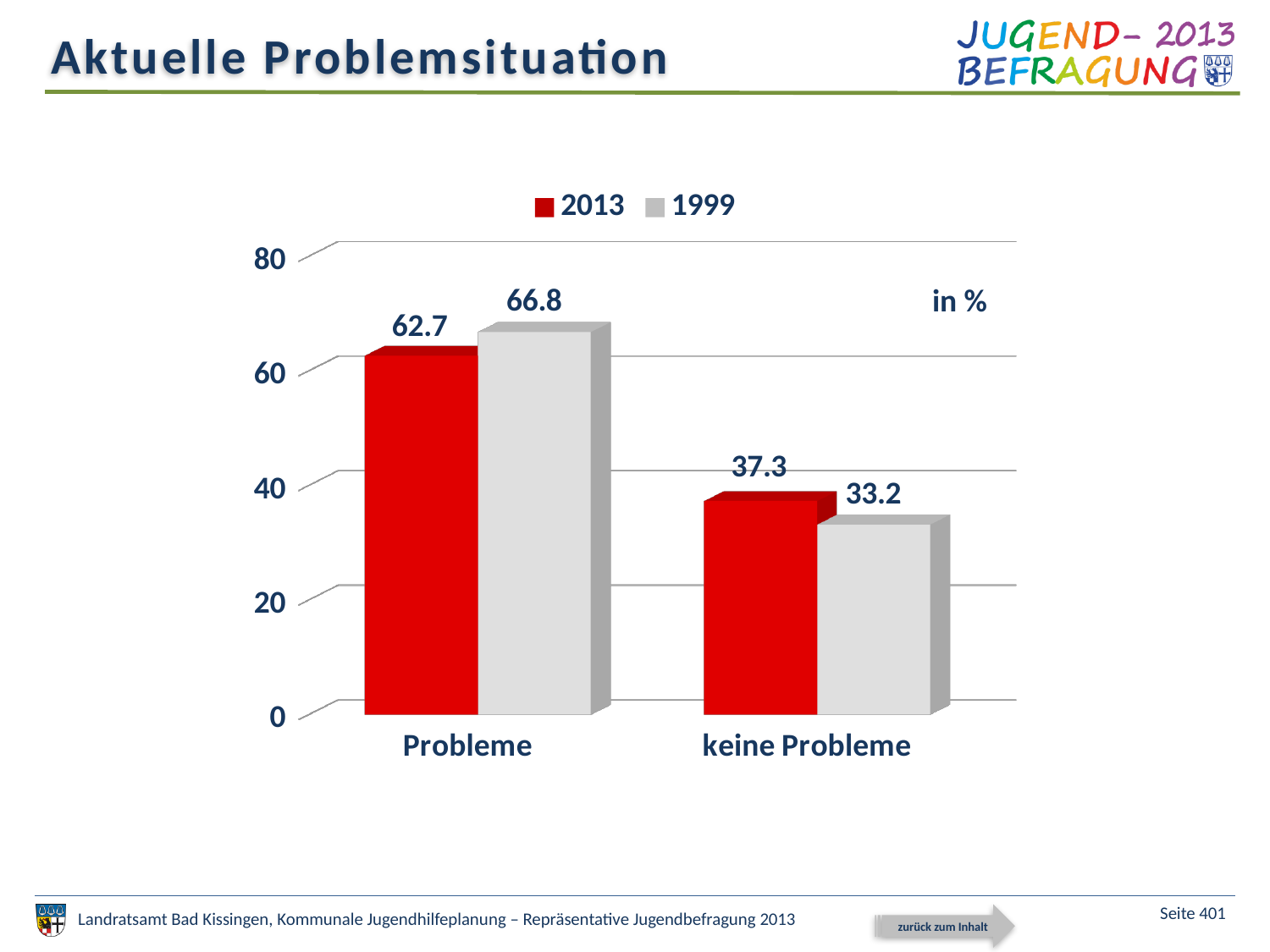
What is the value for keine Probleme in the 1999 series? 33.2 What is the value for Probleme in the 2013 series? 62.7 What is the difference between the 2013 and 1999 values for keine Probleme? 4.1 What is the difference between the 1999 and 2013 values for Probleme? 4.1 What is the value for keine Probleme in the 2013 series? 37.3 What kind of chart is shown on the slide? bar chart Which is larger for keine Probleme, the 2013 value or the 1999 value? 2013 Which category has the lowest value in the 2013 series? keine Probleme What is the value for Probleme in the 1999 series? 66.8 Which category has the highest value in the 1999 series? Probleme How many categories are shown on the x axis? 2 How many series does the legend list? 2